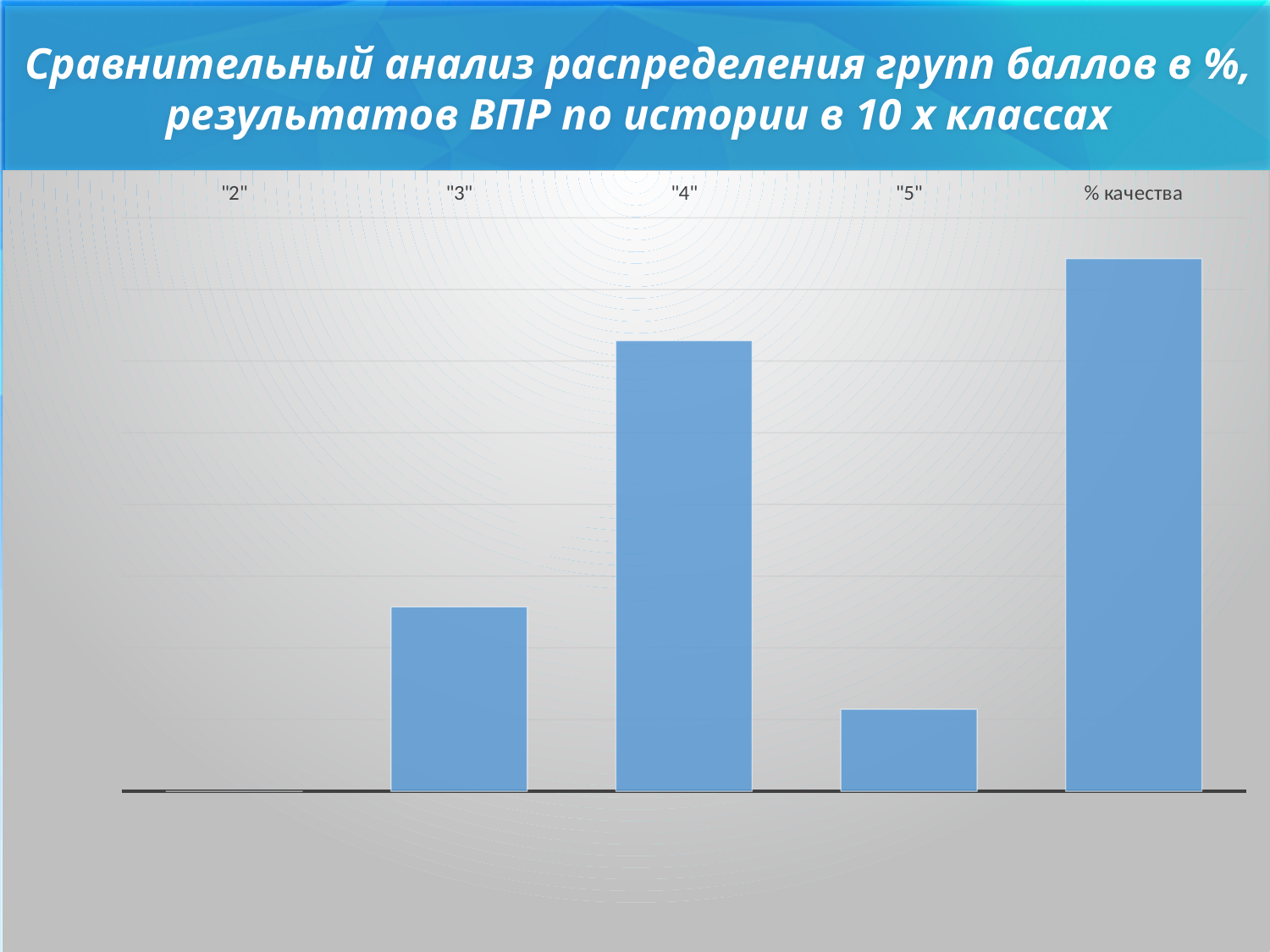
Which is larger, the bar for "3" or the bar for "5"? "3" What kind of chart is shown on the slide? bar chart What subject do the ВПР results in the slide title refer to? история How many categories are shown on the x axis of the chart? 5 Among the score groups "2", "3", "4" and "5", which has the tallest bar? "4" Which is larger, the bar for "4" or the bar for "% качества"? % качества Which category has the lowest value in the chart? "2" Which category has the highest bar in the chart? % качества Which is larger, the bar for "2" or the bar for "5"? "5" What is the label of the last category on the x axis? % качества